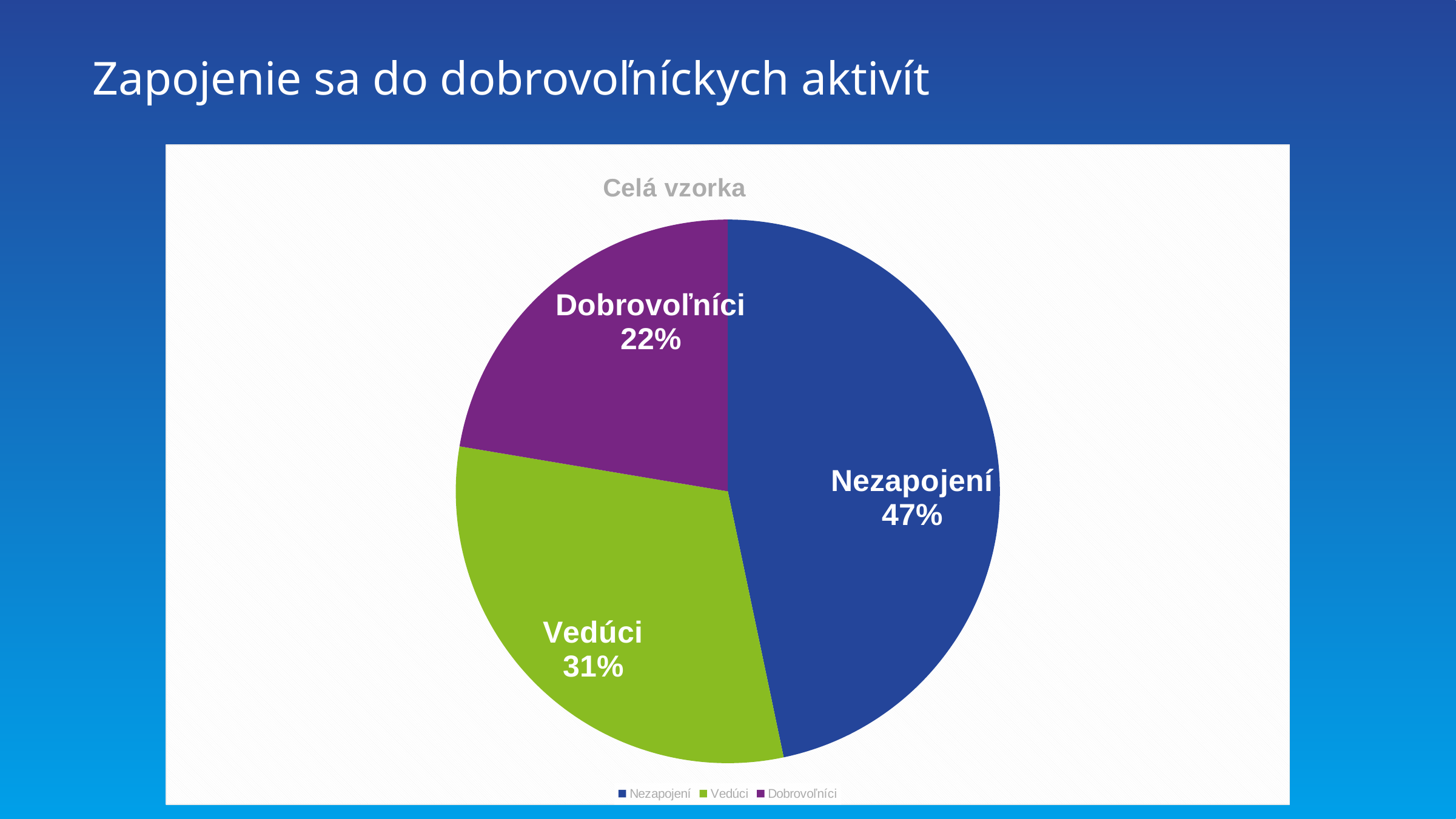
Which category has the largest slice of the pie? Nezapojení How many slices does the pie chart have? 3 What share of the pie is Nezapojení? 47% What share of the pie is Vedúci? 31% What is the difference in percentage points between Vedúci and Dobrovoľníci? 9 Which category has the smallest slice of the pie? Dobrovoľníci What share of the pie is Dobrovoľníci? 22% Which is larger, the share for Vedúci or the share for Dobrovoľníci? Vedúci What kind of chart is shown on the slide? pie chart What is the title of the chart? Celá vzorka How many entries does the legend list? 3 What is the difference in percentage points between Nezapojení and Vedúci? 16